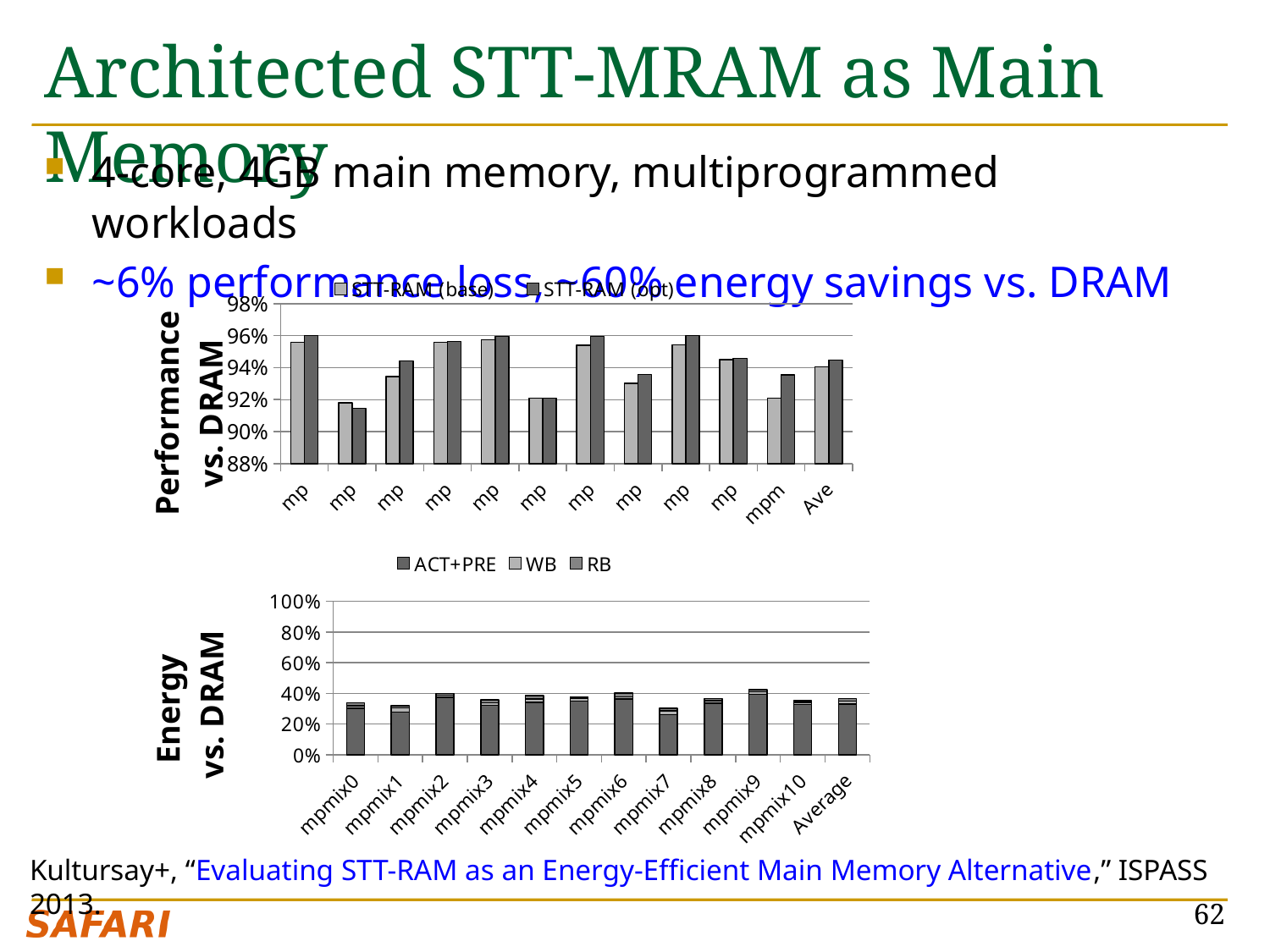
In the top "Performance vs. DRAM" chart, what is the lowest value shown on the y axis? 88% In the bottom "Energy vs. DRAM" chart, which category has the tallest stacked bar? mpmix9 In the bottom "Energy vs. DRAM" chart, what are the three legend entries? ACT+PRE, WB, RB In the bottom "Energy vs. DRAM" chart, which stacked bar is taller, mpmix9 or mpmix7? mpmix9 In the bottom "Energy vs. DRAM" chart, which category has the shortest stacked bar? mpmix7 In the bottom "Energy vs. DRAM" chart, is the total stacked value for mpmix2 greater or less than 20%? greater In the bottom "Energy vs. DRAM" chart, is the total stacked value for Average greater or less than 60%? less In the bottom "Energy vs. DRAM" chart, how many series does the legend list? 3 In the top "Performance vs. DRAM" chart, how many series does the legend list? 2 In the bottom "Energy vs. DRAM" chart, how many categories are shown on the x axis? 12 In the bottom "Energy vs. DRAM" chart, is the total stacked value for mpmix7 greater or less than 40%? less What kind of chart is the bottom chart titled "Energy vs. DRAM"? Stacked bar chart